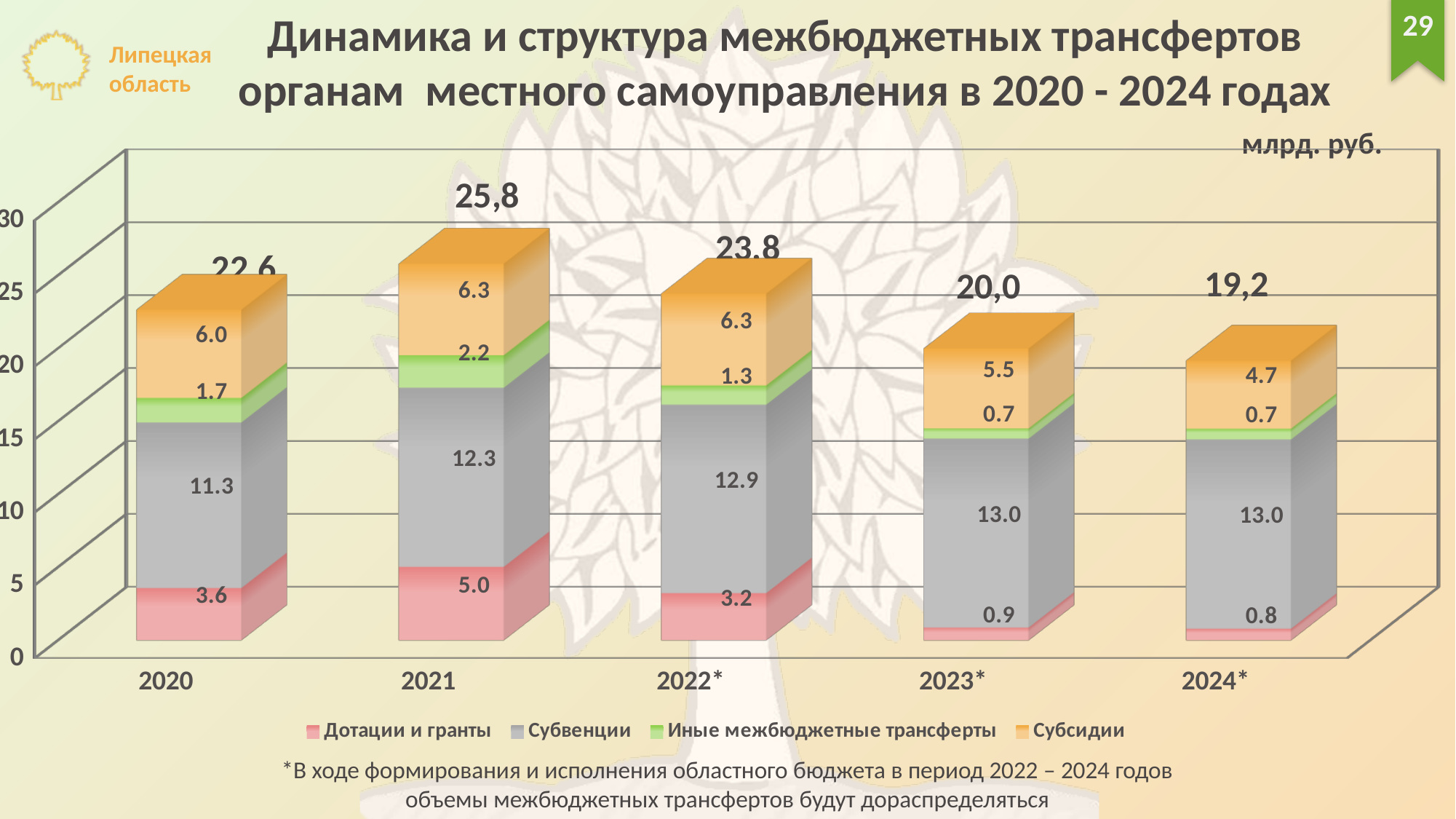
Which year has the highest total of intergovernmental transfers? 2021 What is the difference between Субсидии in 2020 and Субсидии in 2023*? 0.5 How many years are shown on the x axis? 5 Which is larger: Дотации и гранты in 2021 or in 2022*? 2021 Which year has the lowest total of intergovernmental transfers? 2024* What is the value of Субвенции for 2021? 12.3 Do the bar totals rise or fall from 2021 to 2024*? Fall What is the value of Субсидии for 2024*? 4.7 What kind of chart is shown on the slide? Stacked bar chart What is the total of the stacked bar for 2021? 25,8 What is the value of Дотации и гранты for 2020? 3.6 How many series does the legend list? 4